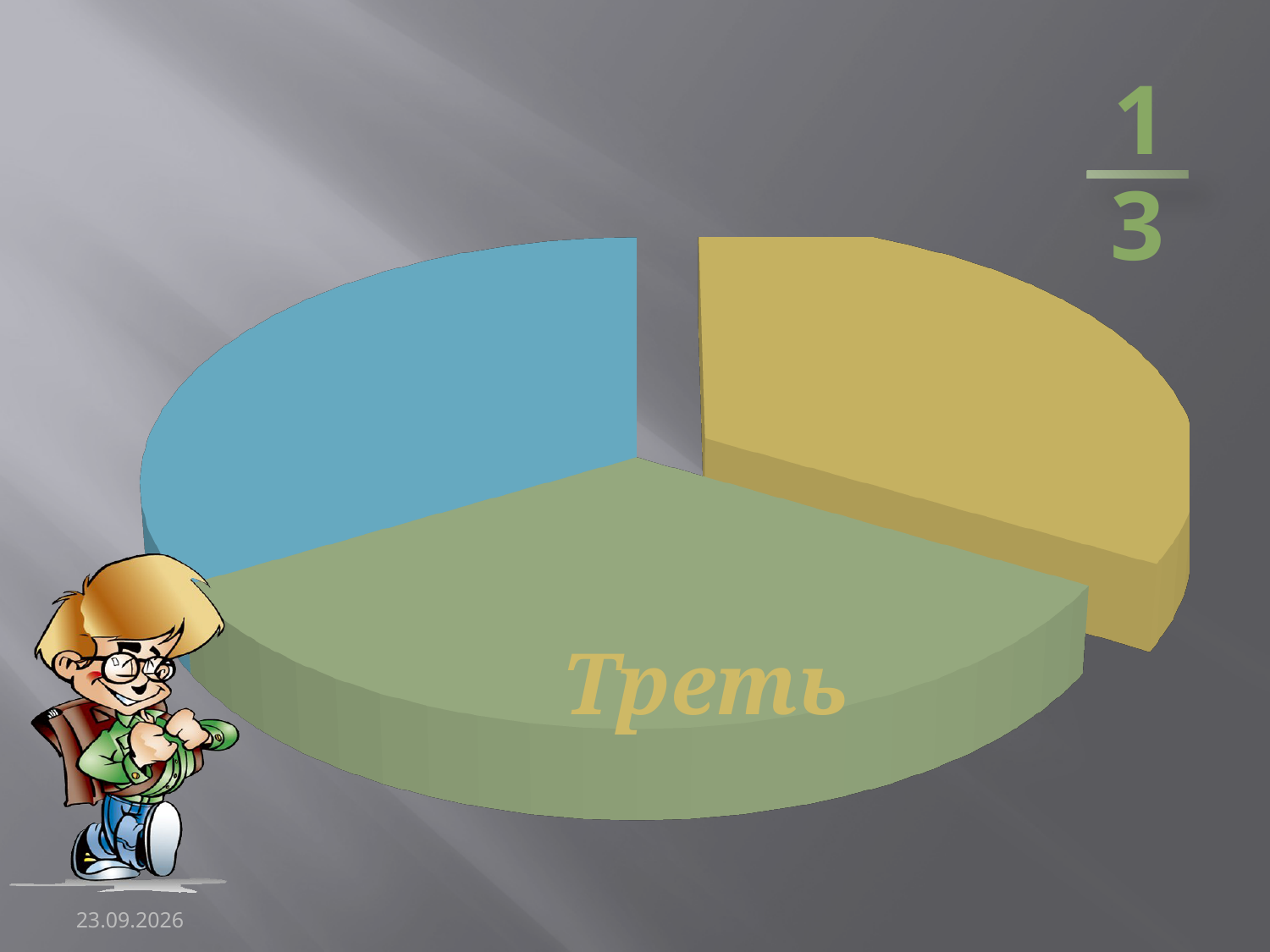
What word is written on the pie chart? Треть Which colour slice is pulled out from the pie chart? yellow How many slices does the pie chart have? 3 What fraction is written next to the pie chart? 1/3 What kind of chart is shown on the slide? pie chart